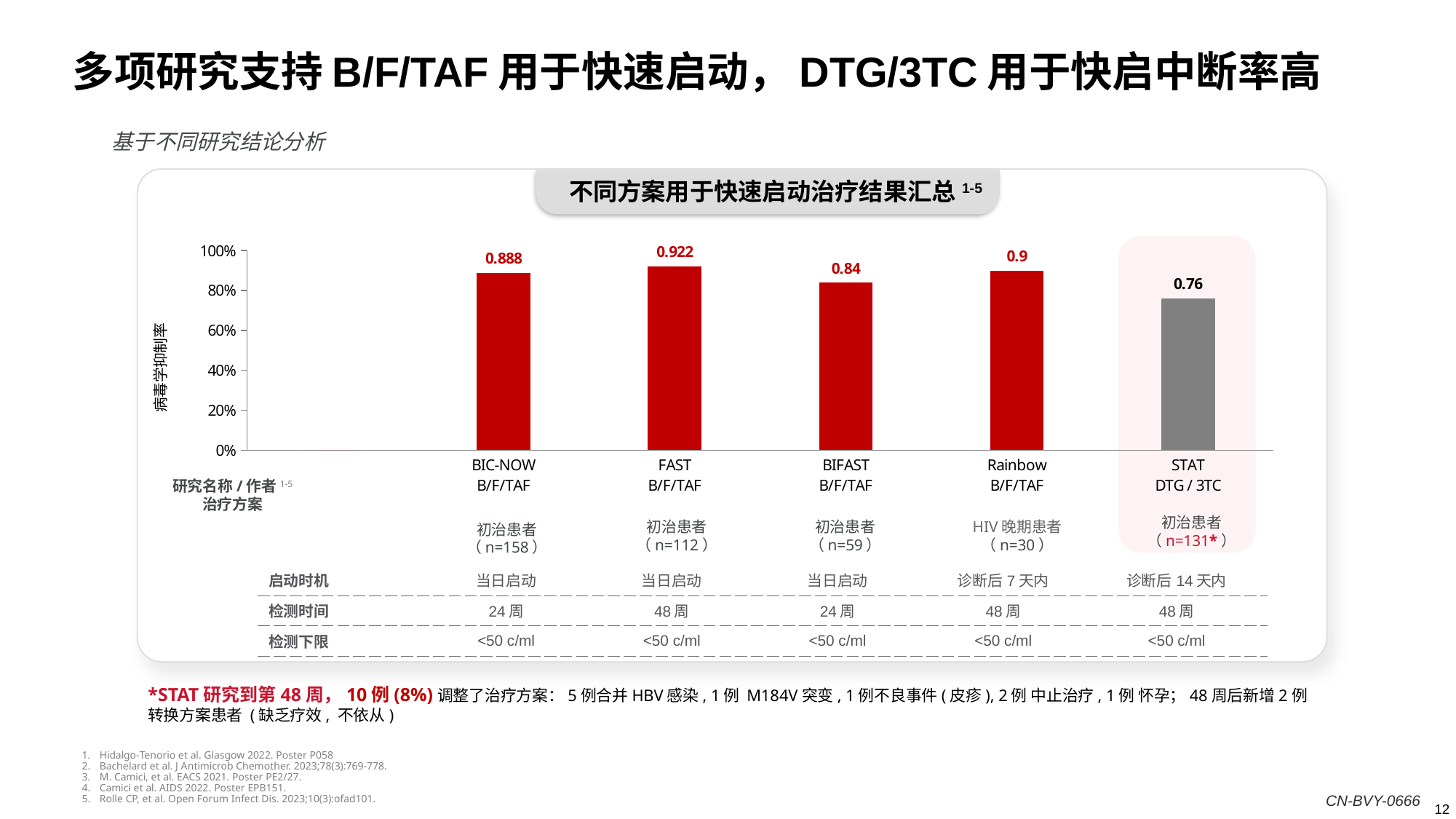
Which is larger, the value for BIC-NOW or the value for BIFAST? BIC-NOW What kind of chart is shown on the slide? bar chart Which bar is coloured grey rather than red? STAT DTG / 3TC What is the difference between the values for Rainbow and BIFAST? 0.06 How many bars are plotted in the chart? 5 What is the difference between the values for FAST and STAT? 0.162 What is the value shown for the STAT DTG / 3TC bar? 0.76 Is the value for STAT greater or less than 80%? less Which study has the lowest value in the chart? STAT What is the value shown for the BIFAST B/F/TAF bar? 0.84 What is the value shown for the FAST B/F/TAF bar? 0.922 Which study has the highest value in the chart? FAST